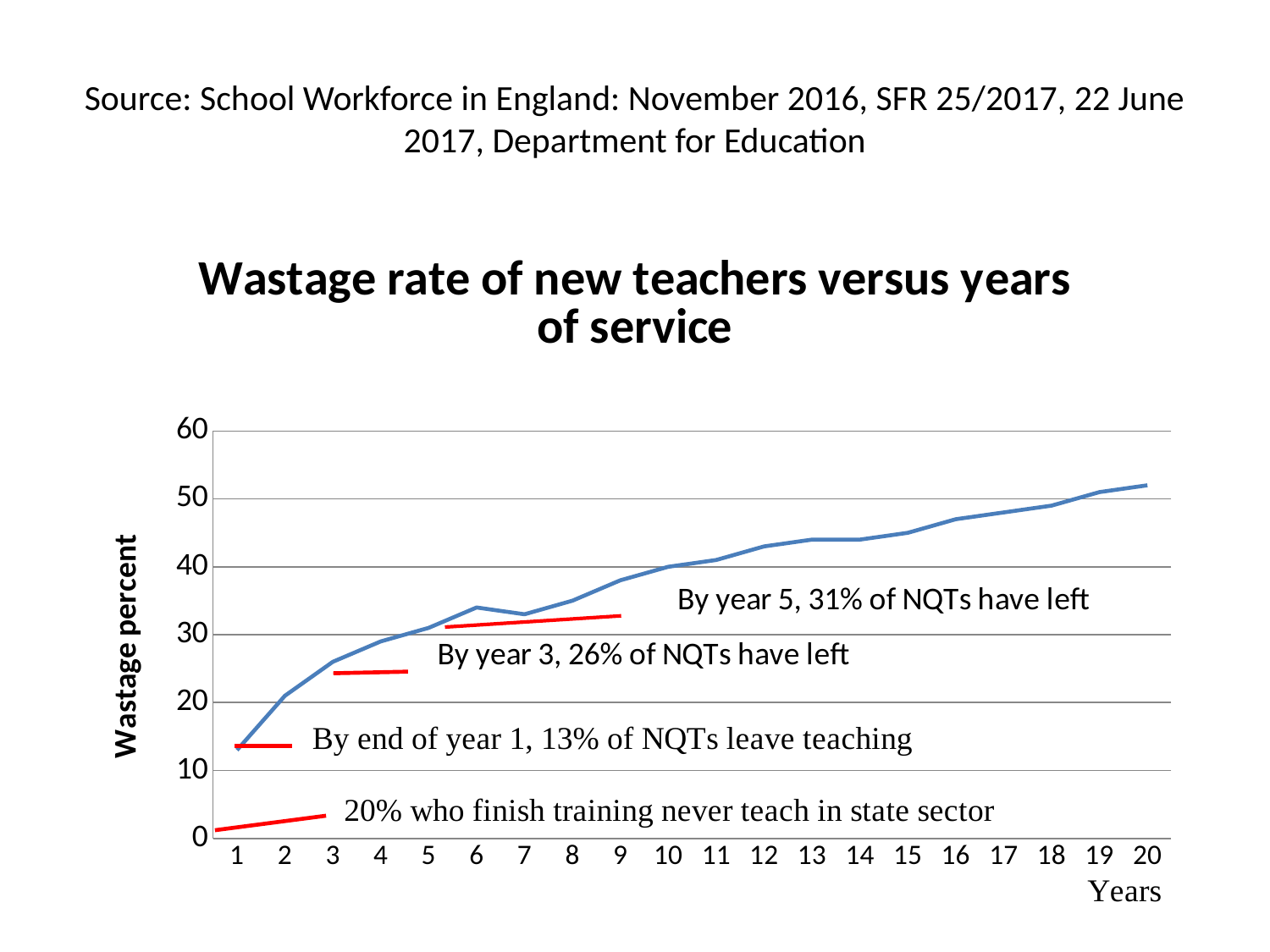
According to the annotation, what percentage of NQTs have left by the end of year 1? 13% According to the annotation, what percentage of NQTs have left by year 5? 31% Is the wastage percent at year 16 greater or less than 50? less According to the annotation, what percentage of NQTs have left by year 3? 26% Is the wastage percent at year 20 greater or less than 50? greater How many years are shown along the x axis of the chart? 20 What is the label on the vertical axis of the chart? Wastage percent What kind of chart is shown on the slide? line chart Which year of service has the lowest wastage percent? 1 Which year of service has the highest wastage percent? 20 Does the wastage percent rise or fall as years of service increase? rise What is the title of the chart? Wastage rate of new teachers versus years of service